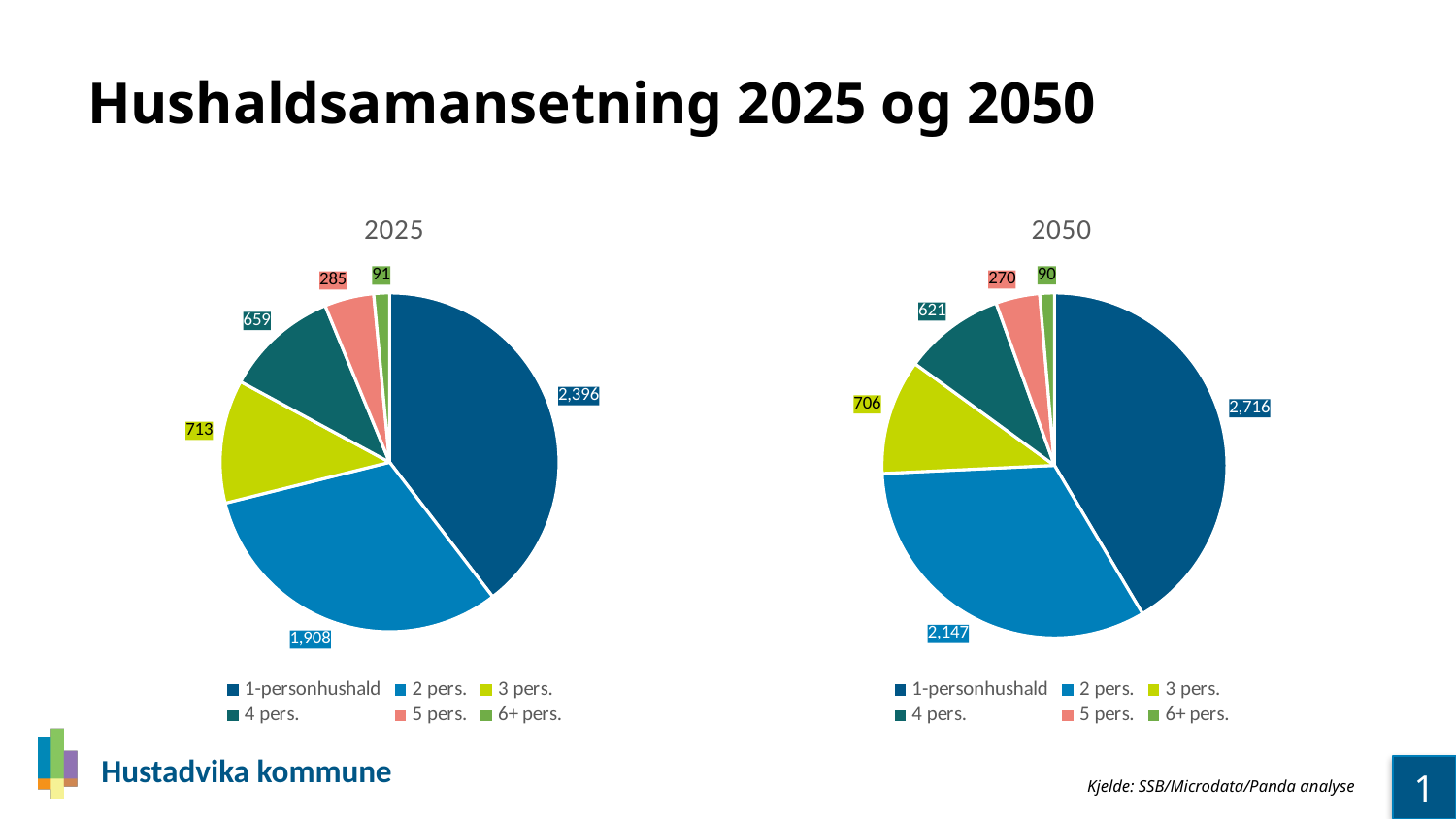
What type of chart is used for the 2050 data? Pie chart In the 2050 pie chart, what is the value for 2 pers.? 2,147 In the 2025 pie chart, which category has the smallest value? 6+ pers. What is the title of the chart on the left? 2025 How many categories does the 2025 pie chart show? 6 In the 2025 pie chart, what is the value for 5 pers.? 285 In the 2050 pie chart, which is larger: the value for 4 pers. or the value for 5 pers.? 4 pers. What is the difference between the 1-personhushald value in the 2050 chart and the 1-personhushald value in the 2025 chart? 320 In the 2025 pie chart, what is the difference between the values for 2 pers. and 3 pers.? 1,195 In the 2025 pie chart, what is the value for 1-personhushald? 2,396 In the 2050 pie chart, which category has the largest value? 1-personhushald In the 2050 pie chart, what is the value for 3 pers.? 706